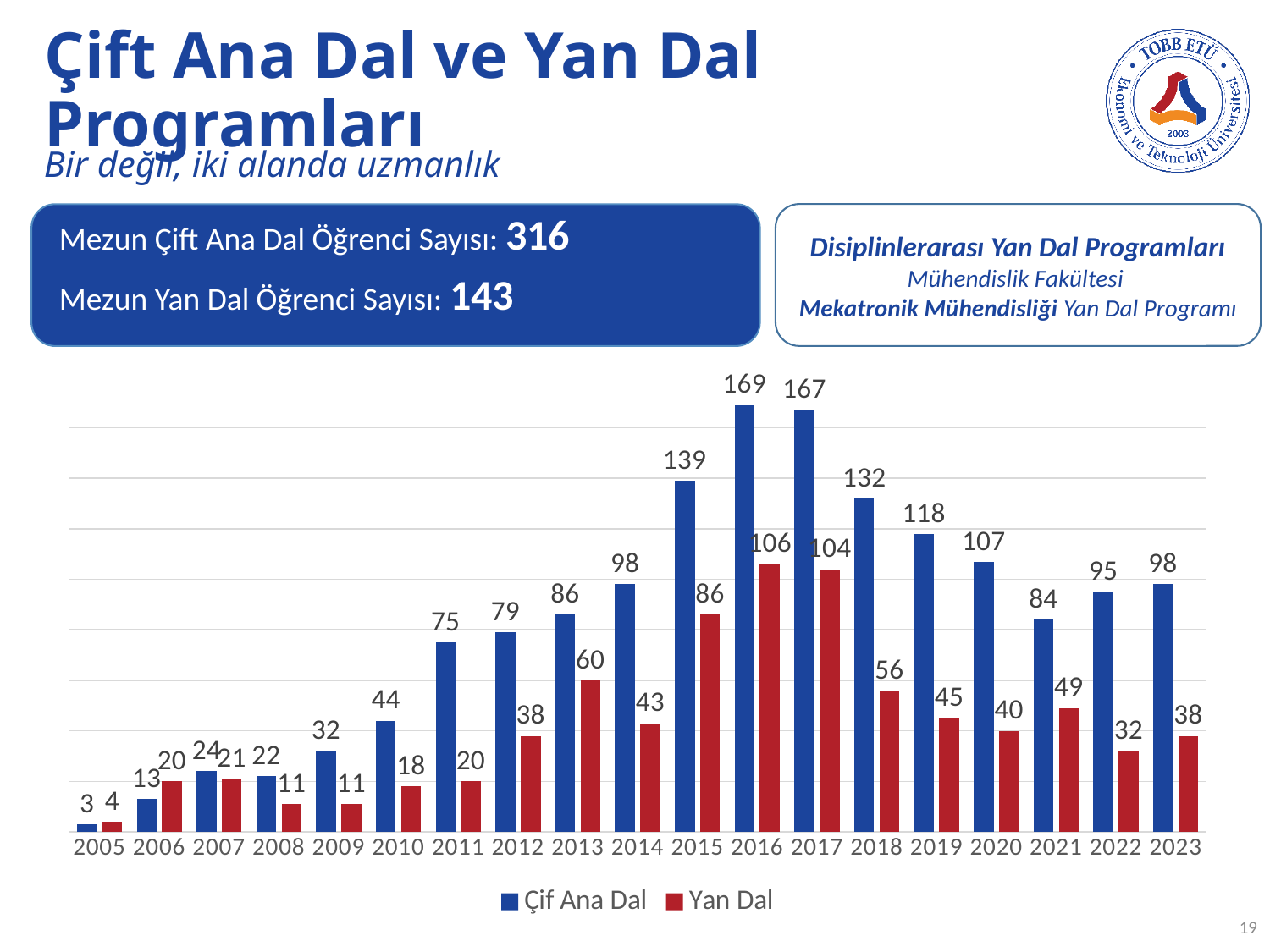
What is the difference between the Çif Ana Dal and Yan Dal values in 2018? 76 Do the Çif Ana Dal values rise or fall from 2016 to 2021? Fall What is the value for Çif Ana Dal in 2016? 169 How many series does the chart's legend list? 2 What colour are the Yan Dal bars in the chart? Red What is the value for Çif Ana Dal in 2023? 98 What is the value for Yan Dal in 2013? 60 In which year is the Çif Ana Dal value highest? 2016 In which year is the Yan Dal value lowest? 2005 What kind of chart is shown on the slide? Bar chart How many years are shown on the x axis of the chart? 19 Which is larger in 2007: the Çif Ana Dal value or the Yan Dal value? Çif Ana Dal